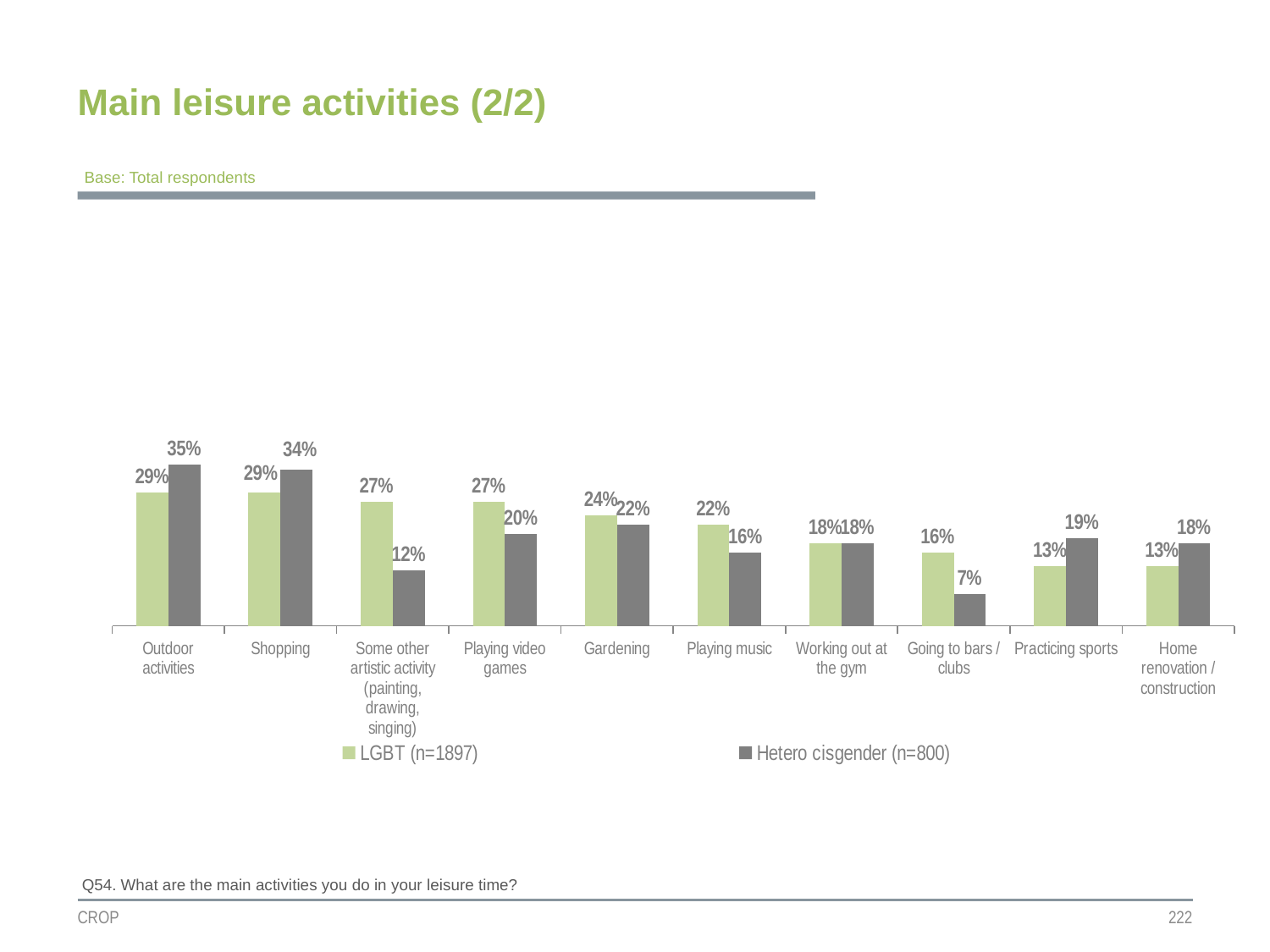
What is the difference between the LGBT and Hetero cisgender values for Some other artistic activity (painting, drawing, singing)? 15 percentage points What is the sample size for the Hetero cisgender group shown in the legend? n=800 How many leisure activities are shown on the x axis? 10 How many series does the legend list? 2 What percentage of LGBT respondents chose Outdoor activities? 29% Which activity has the lowest value for Hetero cisgender respondents? Going to bars / clubs What percentage of Hetero cisgender respondents chose Going to bars / clubs? 7% What is the value for Hetero cisgender respondents for Playing video games? 20% Which activity has the highest value for Hetero cisgender respondents? Outdoor activities Which group has the larger value for Practicing sports, LGBT or Hetero cisgender? Hetero cisgender What kind of chart is shown on the slide? Bar chart Which group has the larger value for Gardening, LGBT or Hetero cisgender? LGBT